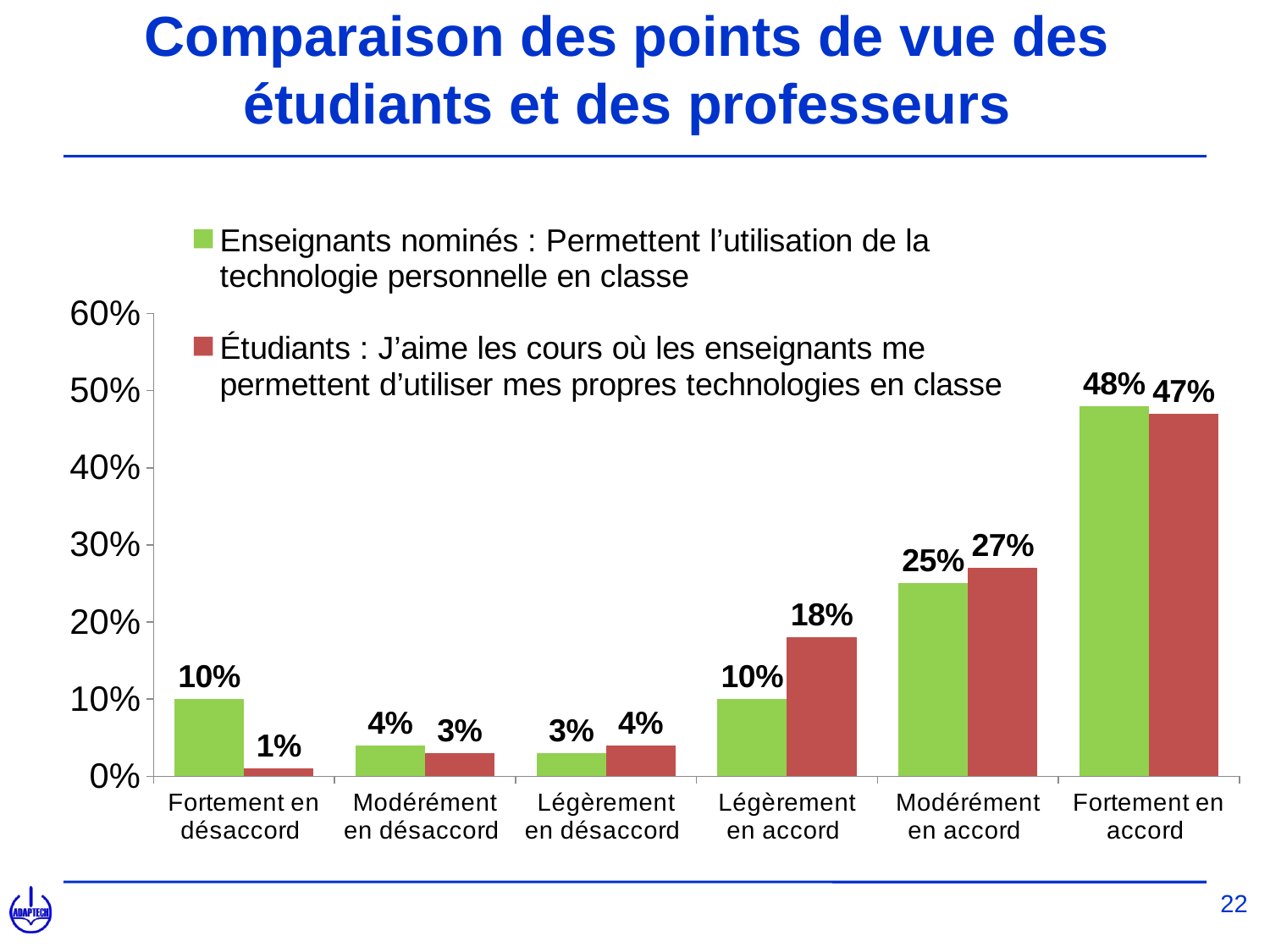
What is the value for Enseignants nominés in the Fortement en accord category? 48% Which category has the highest value for the Étudiants series? Fortement en accord Which category has the lowest value for the Étudiants series? Fortement en désaccord What is the value for Étudiants in the Fortement en désaccord category? 1% What colour are the bars for the Étudiants series? Red What is the difference between the Étudiants and Enseignants nominés values in the Légèrement en accord category? 8% In the Modérément en accord category, which series has the larger value? Étudiants How many series does the legend list? 2 What kind of chart is shown on the slide? Bar chart What is the value for Étudiants in the Légèrement en accord category? 18% How many categories are shown on the x axis? 6 In the Fortement en désaccord category, which series has the larger value? Enseignants nominés